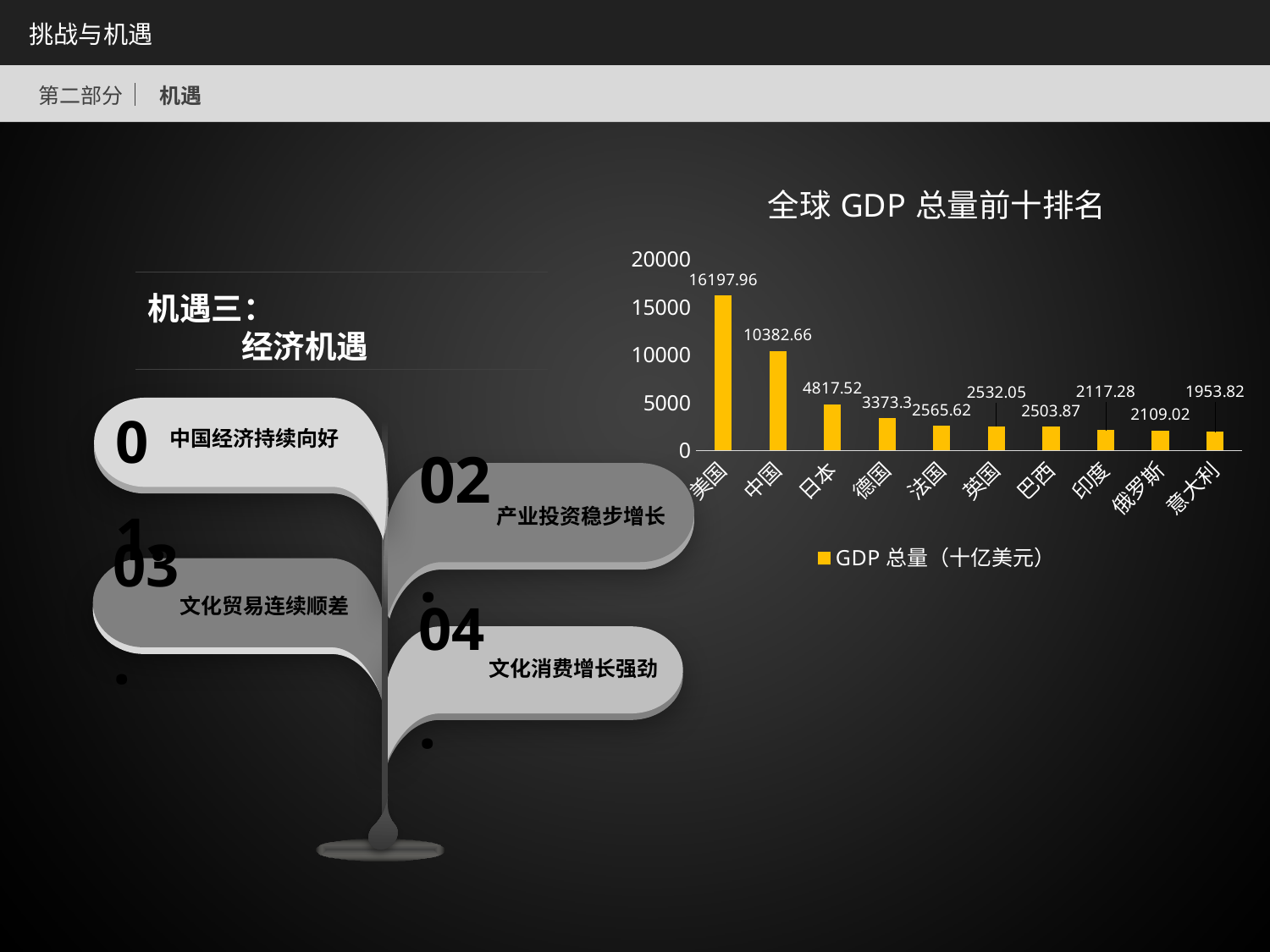
How many countries are shown in the chart? 10 What type of chart is used to show the GDP ranking? bar chart What is the GDP value shown for 中国? 10382.66 What is the difference between the GDP values of 美国 and 中国? 5815.3 What is the legend entry of the chart? GDP 总量（十亿美元） What is the GDP value shown for 意大利? 1953.82 Which has a larger GDP value, 日本 or 德国? 日本 Which country has the highest GDP in the chart? 美国 Which country has the lowest GDP in the chart? 意大利 What is the GDP value shown for 美国? 16197.96 Is the value for 中国 greater or less than 10000? greater What is the GDP value shown for 德国? 3373.3